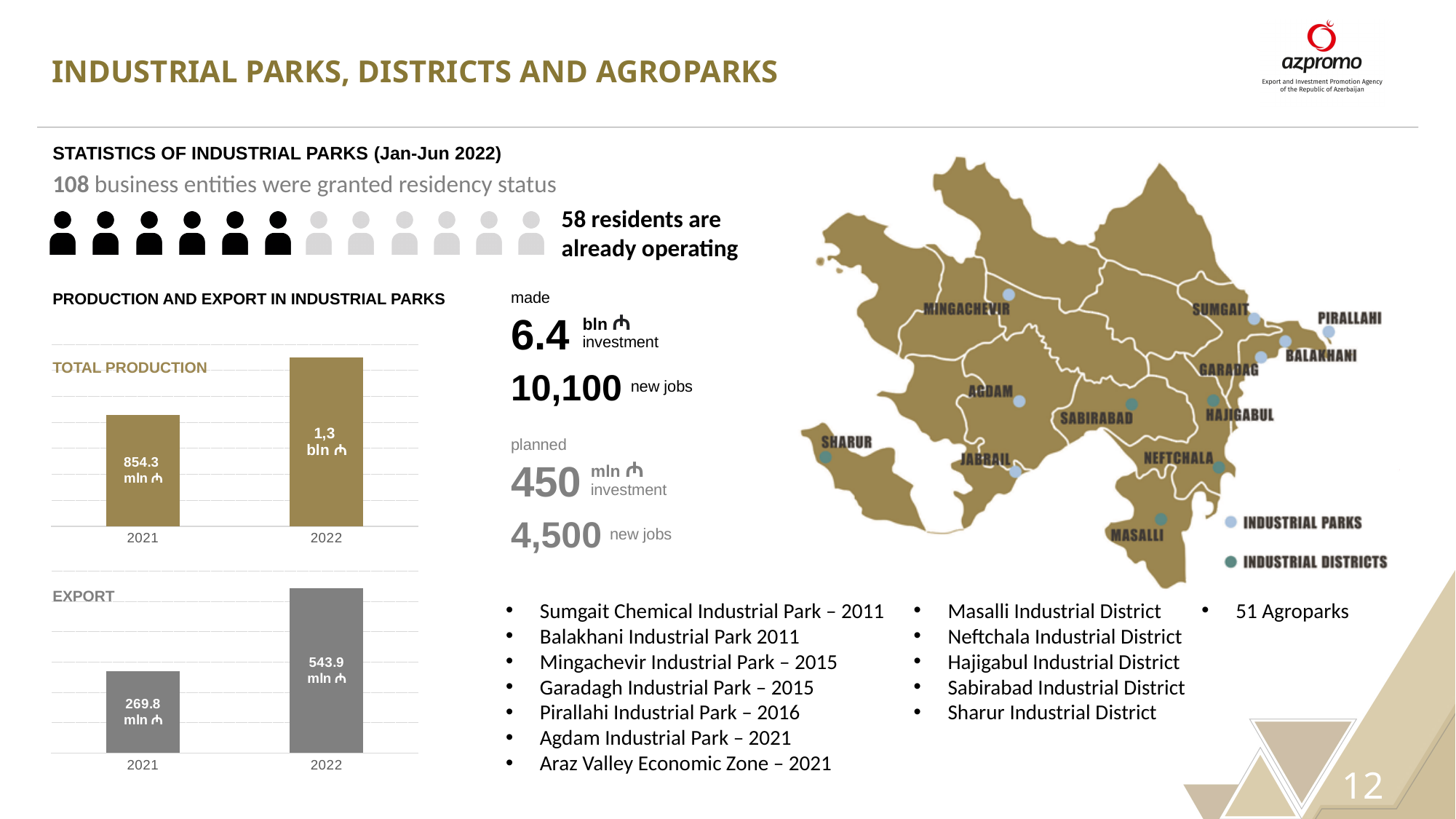
In the TOTAL PRODUCTION chart, is the value for 2022 larger or smaller than the value for 2021? larger How many categories (years) are shown in the EXPORT chart? 2 In the TOTAL PRODUCTION chart, which year has the lower value? 2021 In the EXPORT chart, which year has the higher value? 2022 In the TOTAL PRODUCTION chart, what is the value for 2022? 1,3 bln ₼ What type of chart is the TOTAL PRODUCTION chart? bar chart In the TOTAL PRODUCTION chart, what is the value for 2021? 854.3 mln ₼ In the EXPORT chart, what is the value for 2021? 269.8 mln ₼ What colour are the bars in the EXPORT chart? grey In the EXPORT chart, what is the value for 2022? 543.9 mln ₼ In the EXPORT chart, what is the difference between the 2022 and 2021 values? 274.1 mln ₼ In the EXPORT chart, do the values rise or fall from 2021 to 2022? rise